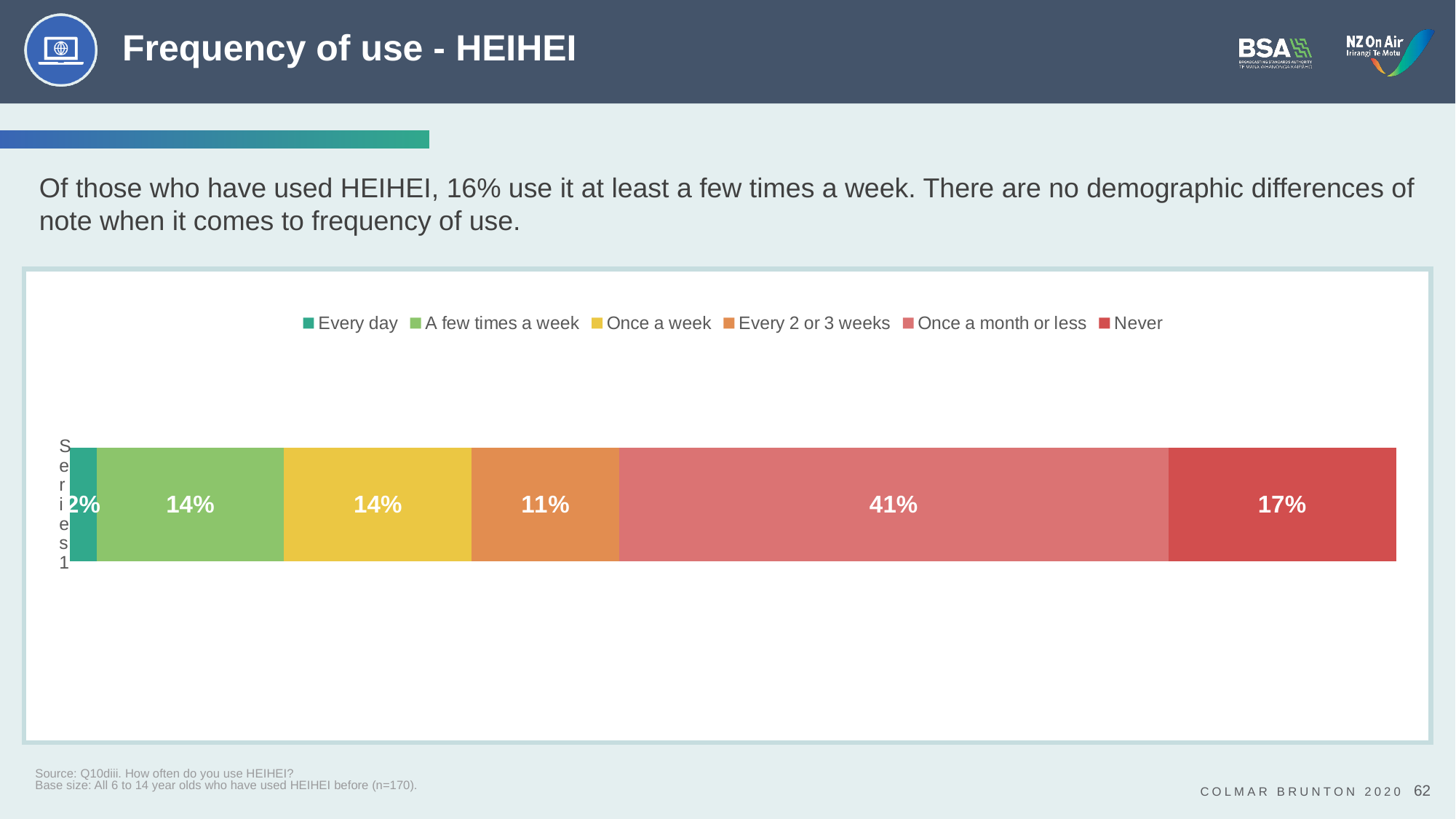
Which is larger: the share who never use HEIHEI or the share who use it every 2 or 3 weeks? Never What type of chart is shown on the slide? Stacked bar chart What percentage of HEIHEI users say they never use it? 17% What is the combined share of HEIHEI users who use it a few times a week or once a week? 28% How many frequency categories does the legend list? 6 What is the difference between the share who use HEIHEI once a month or less and the share who never use it? 24% Which colour represents the 'Never' category in the chart? Red What percentage of HEIHEI users use it every 2 or 3 weeks? 11% What percentage of HEIHEI users use it once a month or less? 41% What percentage of HEIHEI users use it every day? 2% Which frequency category has the smallest share of HEIHEI users? Every day Which frequency category has the largest share of HEIHEI users? Once a month or less